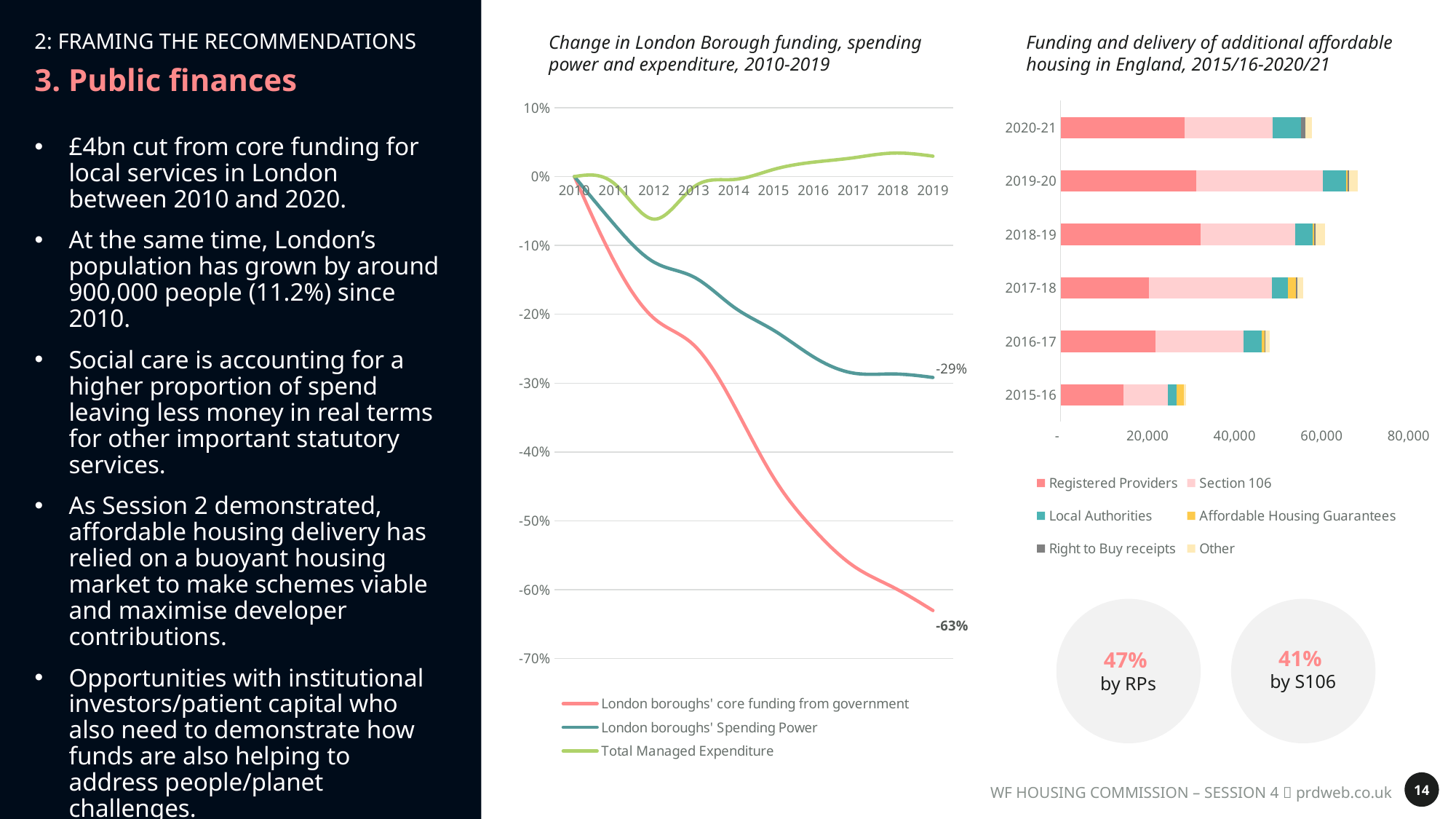
In the chart titled 'Change in London Borough funding, spending power and expenditure, 2010-2019', is the value for Total Managed Expenditure in 2019 greater or less than 0%? greater In the chart titled 'Funding and delivery of additional affordable housing in England, 2015/16-2020/21', how many year categories are shown? 6 What kind of chart is the one titled 'Change in London Borough funding, spending power and expenditure, 2010-2019'? Line chart In the chart titled 'Change in London Borough funding, spending power and expenditure, 2010-2019', how many series does the legend list? 3 In the chart titled 'Funding and delivery of additional affordable housing in England, 2015/16-2020/21', how many series does the legend list? 6 In the chart titled 'Change in London Borough funding, spending power and expenditure, 2010-2019', does the London boroughs' core funding from government line rise or fall from 2010 to 2019? Fall In the chart titled 'Change in London Borough funding, spending power and expenditure, 2010-2019', which series has the lowest value in 2019? London boroughs' core funding from government In the chart titled 'Change in London Borough funding, spending power and expenditure, 2010-2019', what is the value for London boroughs' core funding from government in 2019? -63% In the chart titled 'Change in London Borough funding, spending power and expenditure, 2010-2019', what is the value for London boroughs' Spending Power in 2019? -29% In the chart titled 'Change in London Borough funding, spending power and expenditure, 2010-2019', what is the difference between the 2019 values for London boroughs' Spending Power and London boroughs' core funding from government? 34 percentage points In the chart titled 'Funding and delivery of additional affordable housing in England, 2015/16-2020/21', is the total bar for 2015-16 greater or less than 40,000? less What kind of chart is the one titled 'Funding and delivery of additional affordable housing in England, 2015/16-2020/21'? Stacked bar chart